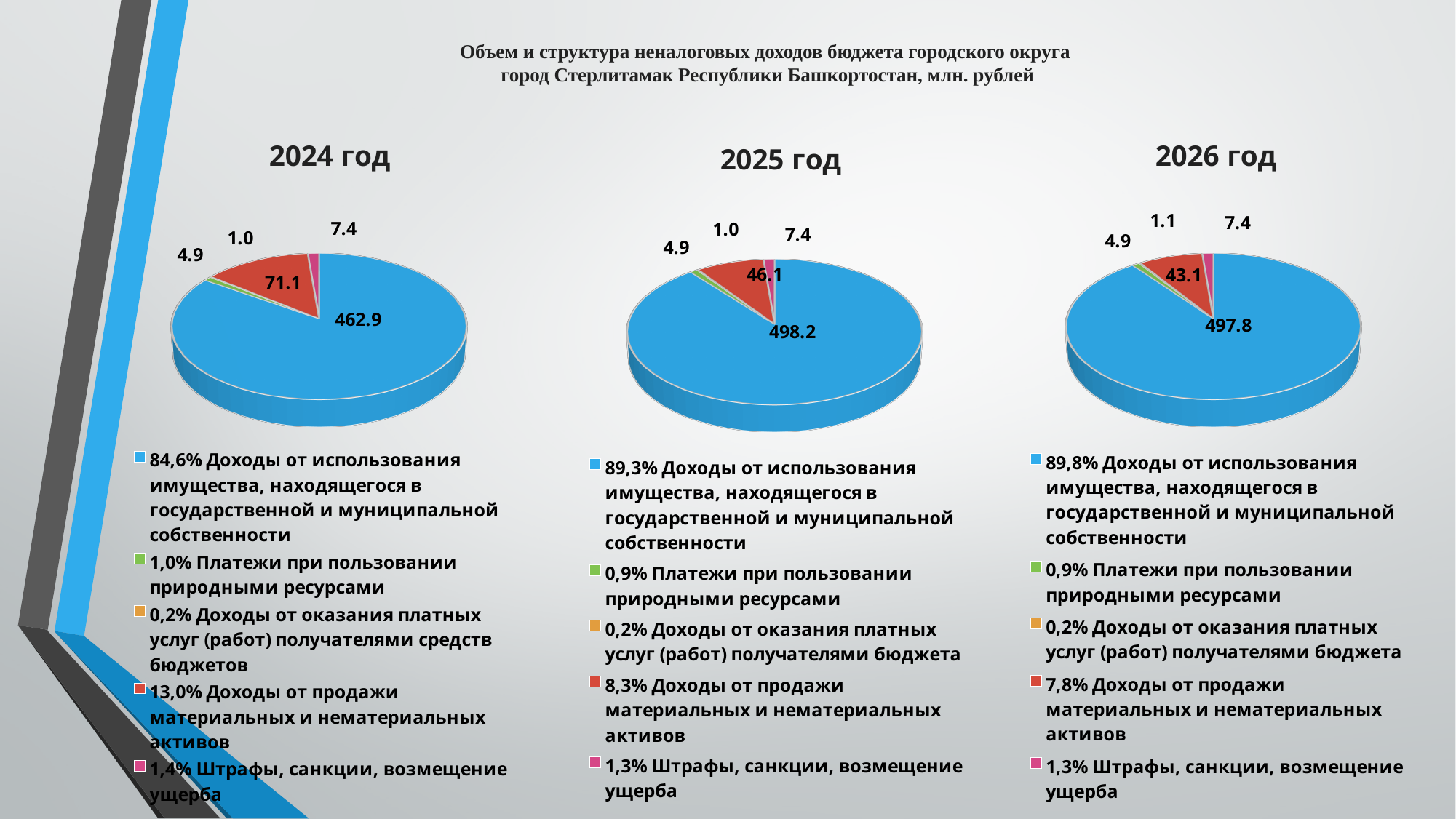
How many pie charts are on the slide? 3 Which is larger: the value for Доходы от продажи активов in 2024 год (71.1) or in 2026 год (43.1)? 2024 год (71.1) How many categories does the legend of the 2026 год chart list? 5 In the 2024 год chart, which category has the largest slice? Доходы от использования имущества, находящегося в государственной и муниципальной собственности What type of charts are shown on the slide? Pie charts What colour is the slice for Доходы от продажи материальных и нематериальных активов in each chart? Red In the 2024 год chart, what is the value of the largest slice (Доходы от использования имущества)? 462.9 In the 2025 год chart, what share of the pie does Доходы от использования имущества represent according to the legend? 89,3% In the 2024 год chart, what is the difference between the value for Доходы от использования имущества (462.9) and Доходы от продажи активов (71.1)? 391.8 In the 2026 год chart, which category has the smallest slice? Доходы от оказания платных услуг (работ) получателями бюджета In the 2026 год chart, what is the value for Штрафы, санкции, возмещение ущерба? 7.4 In the 2025 год chart, what is the value for Доходы от продажи материальных и нематериальных активов? 46.1